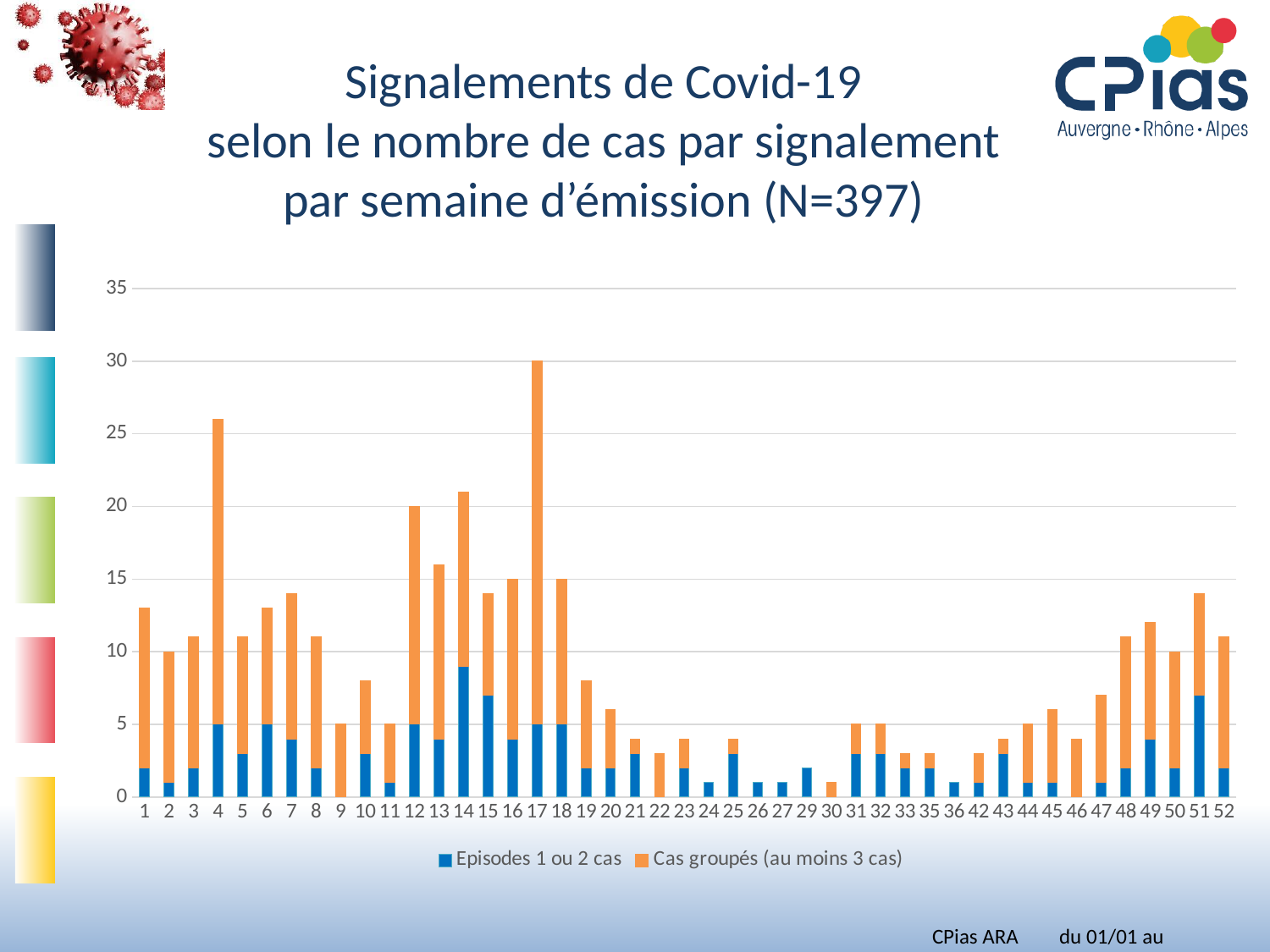
Which has a larger total, week 4 or week 14? week 4 What is the total N given in the chart title? 397 What kind of chart is shown on the slide? bar chart What is the total height of the stacked bar for week 17? 30 Which week has the highest total number of signalements? 17 Is the total value for week 14 greater or less than 20? greater Is the total value for week 22 greater or less than 5? less What is the total height of the stacked bar for week 12? 20 Is the total value for week 49 greater or less than 10? greater What are the two series named in the legend? Episodes 1 ou 2 cas; Cas groupés (au moins 3 cas) How many series does the legend list? 2 Do the total values generally rise or fall from week 17 to week 30? fall